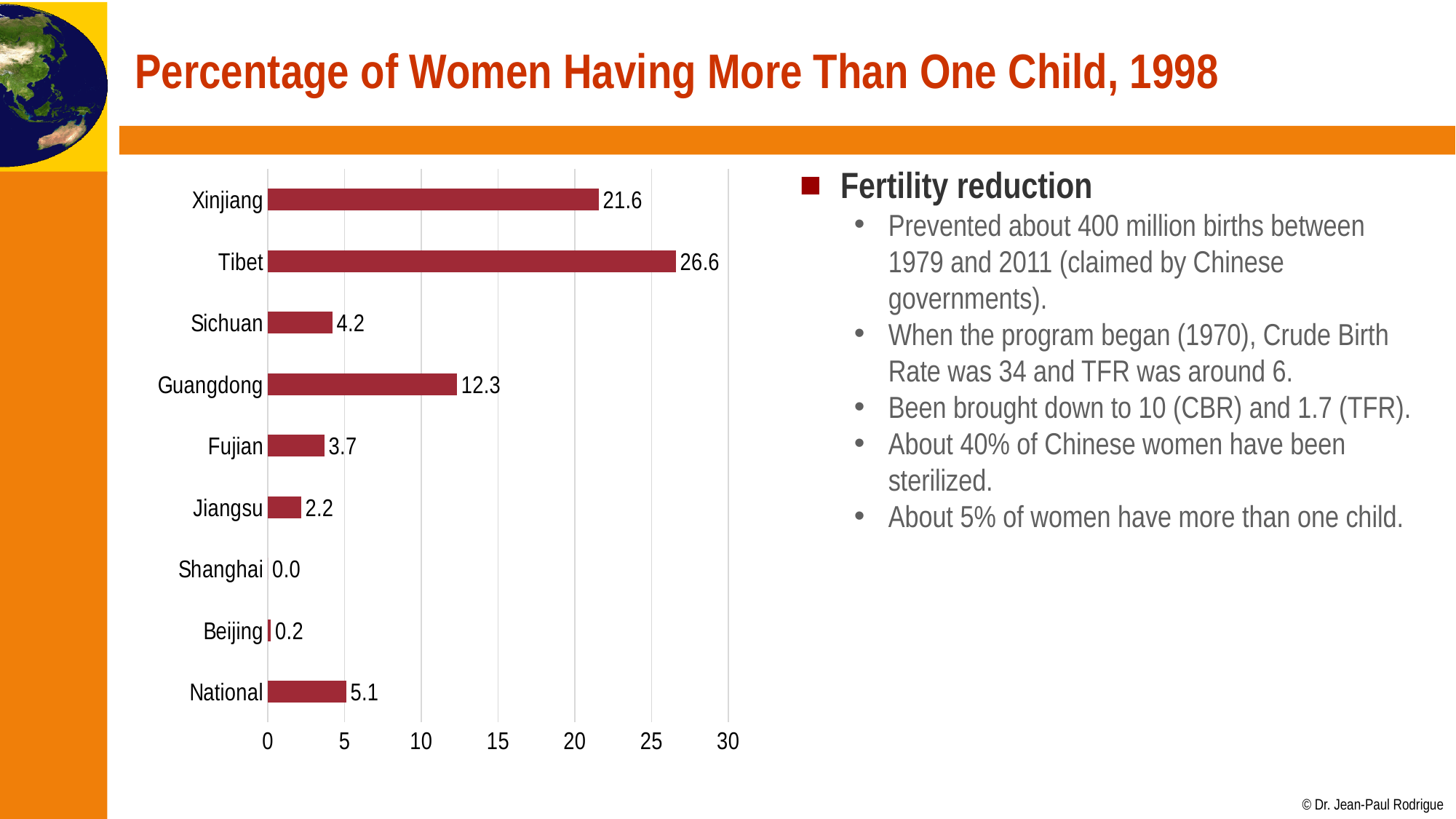
What is the National value? 5.1 Which category has the lowest value? Shanghai What kind of chart is shown on the slide? bar chart Which is larger, the value for Sichuan or the value for Fujian? Sichuan What is the difference between the National value and the value for Jiangsu? 2.9 Which category has the highest value? Tibet What is the difference between the values for Tibet and Xinjiang? 5.0 Is the value for Xinjiang greater or less than 20? greater What is the title of the slide containing the chart? Percentage of Women Having More Than One Child, 1998 What is the value for Guangdong? 12.3 How many categories are shown on the chart? 9 What is the value for Tibet? 26.6